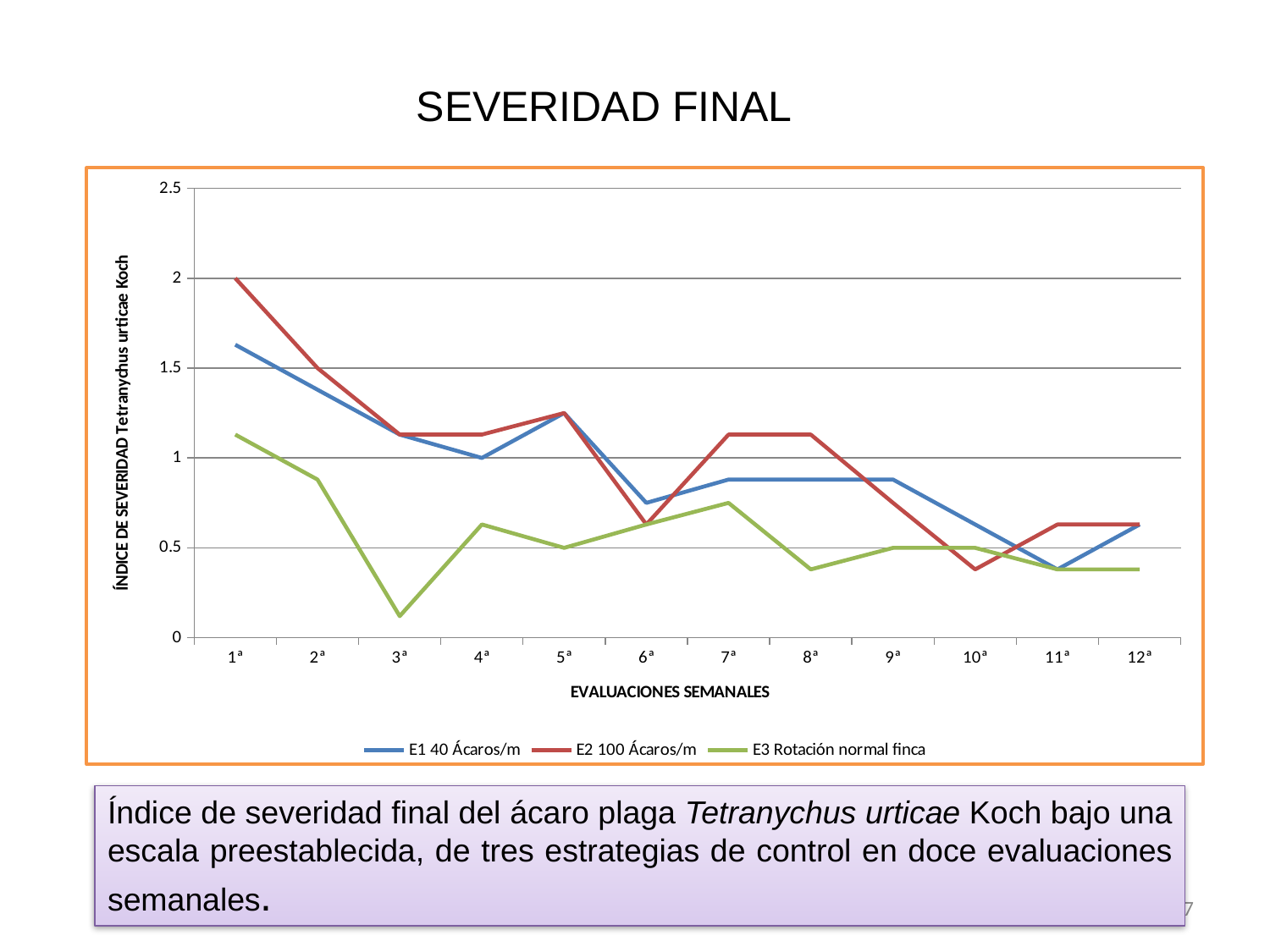
Is the value for E1 40 Ácaros/m at the 1ª evaluation greater or less than 1.5? greater How many weekly evaluations are plotted along the x axis? 12 At the 8ª evaluation, which is larger: E2 100 Ácaros/m or E3 Rotación normal finca? E2 100 Ácaros/m Is the value for E3 Rotación normal finca at the 3ª evaluation greater or less than 0.5? less What is the value for E3 Rotación normal finca at the 5ª evaluation? 0.5 How many series does the legend list? 3 At which evaluation does E3 Rotación normal finca reach its lowest value? 3ª What is the value for E2 100 Ácaros/m at the 1ª evaluation? 2 Which series has the highest value at the 1ª evaluation? E2 100 Ácaros/m What is the value for E1 40 Ácaros/m at the 4ª evaluation? 1 Overall, do the values for E2 100 Ácaros/m rise or fall from the 1ª to the 12ª evaluation? fall What kind of chart is shown on the slide? line chart